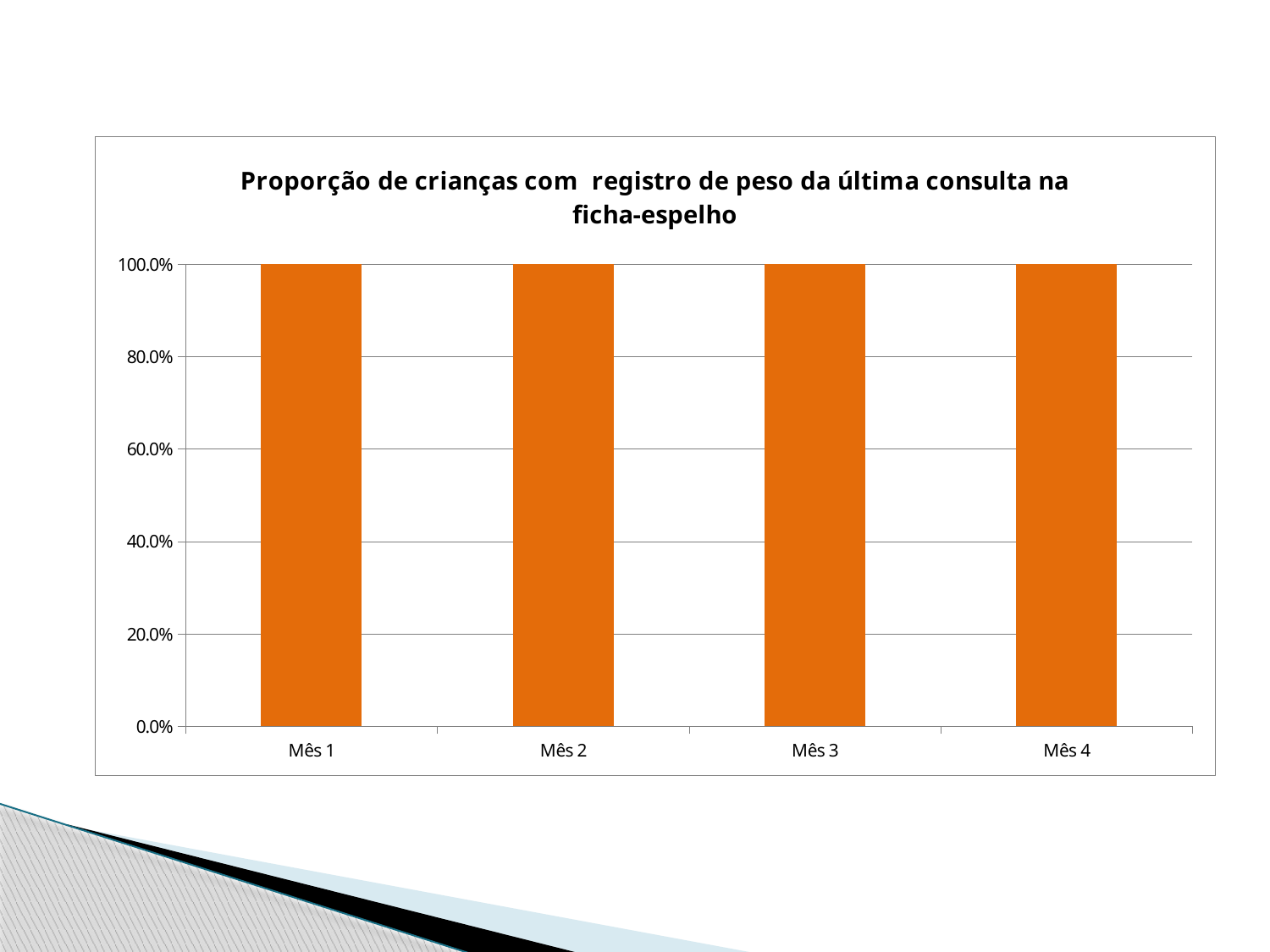
What is the value for Mês 2? 100.0% Do the values rise, fall, or stay the same from Mês 1 to Mês 4? stay the same What is the title of the chart? Proporção de crianças com registro de peso da última consulta na ficha-espelho What is the value for Mês 4? 100.0% How many categories (months) are shown on the x axis? 4 What is the value for Mês 3? 100.0% What is the difference between the values for Mês 1 and Mês 3? 0.0% Is the value for Mês 2 greater or less than 80.0%? greater What is the value for Mês 1? 100.0% Is the value for Mês 4 greater or less than 60.0%? greater What type of chart is shown on the slide? bar chart What colour are the bars in the chart? orange